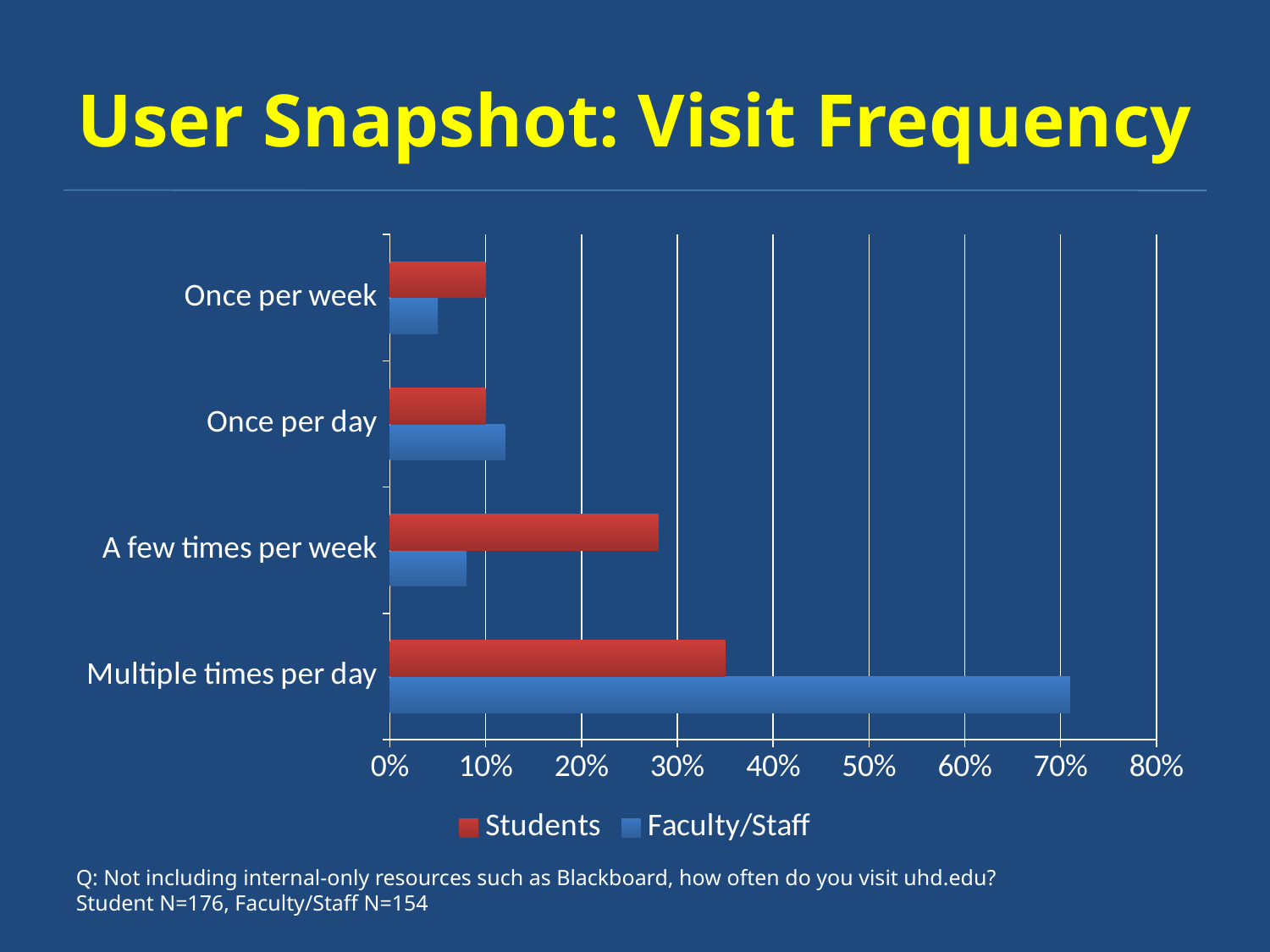
How many series does the legend list? 2 Is the Faculty/Staff value for Multiple times per day greater or less than 60%? greater Which category has the highest value for Students? Multiple times per day For A few times per week, which is larger: Students or Faculty/Staff? Students For Multiple times per day, which is larger: Students or Faculty/Staff? Faculty/Staff Is the Faculty/Staff value for Once per week greater or less than 10%? less Which category has the lowest value for Faculty/Staff? Once per week Which category has the highest value for Faculty/Staff? Multiple times per day Is the Students value for Multiple times per day greater or less than 30%? greater What kind of chart is shown on the slide? bar chart Which colour represents Students in the legend? red How many visit-frequency categories are shown on the chart? 4